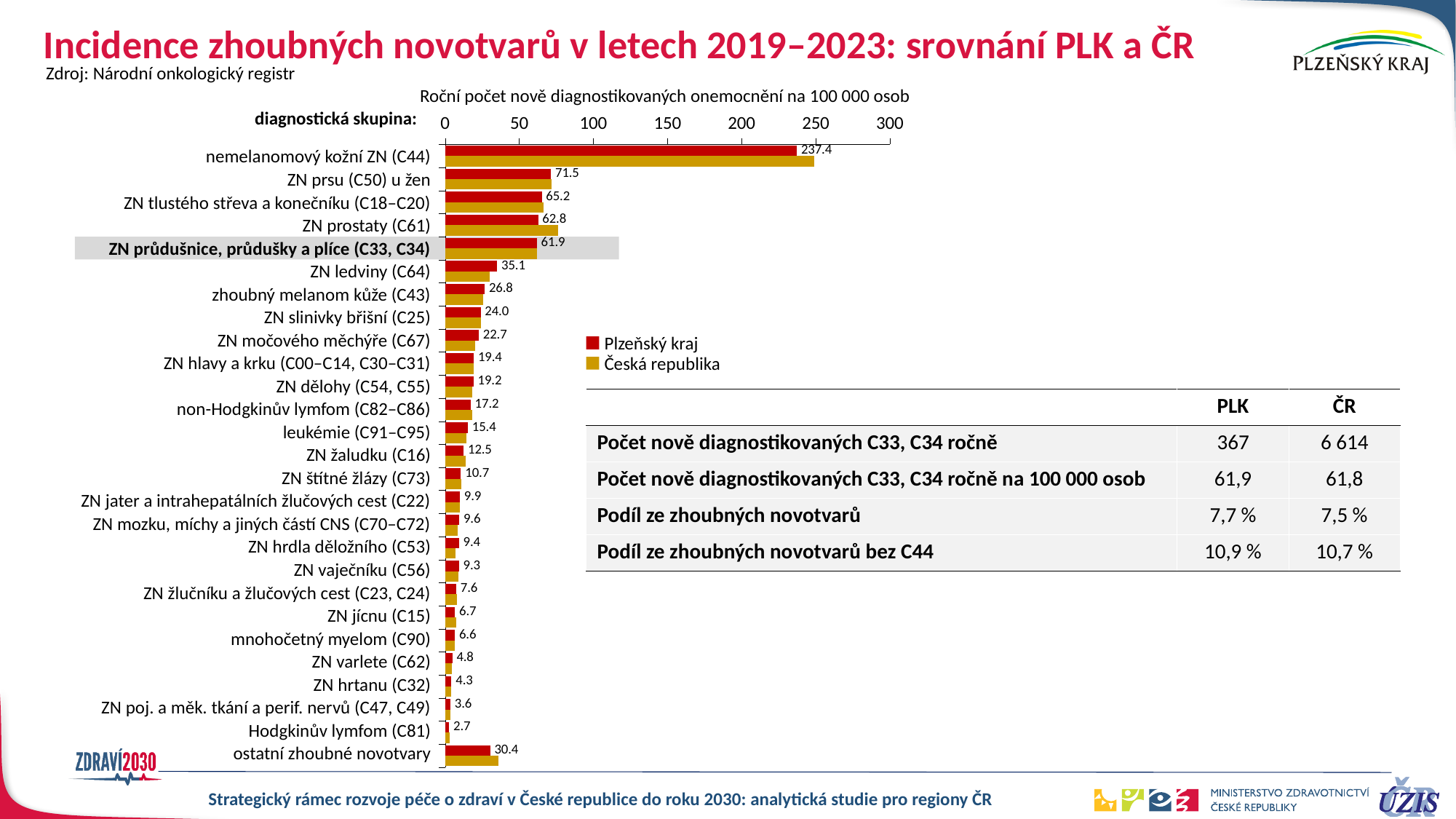
Which diagnostic group has the lowest Plzeňský kraj value? Hodgkinův lymfom (C81) What is the Plzeňský kraj value for ostatní zhoubné novotvary? 30.4 What is the Plzeňský kraj value for ZN prsu (C50) u žen? 71.5 Which has the larger Plzeňský kraj value: ZN ledviny (C64) or zhoubný melanom kůže (C43)? ZN ledviny (C64) How many diagnostic groups are shown in the chart? 27 What is the difference between the Plzeňský kraj values for ZN prsu (C50) u žen and ZN tlustého střeva a konečníku (C18–C20)? 6.3 What kind of chart is shown on the slide? bar chart What is the Plzeňský kraj value for ZN ledviny (C64)? 35.1 How many series does the legend list? 2 Is the Česká republika value for nemelanomový kožní ZN (C44) greater or less than 200? greater Which diagnostic group has the highest Plzeňský kraj value? nemelanomový kožní ZN (C44) Is the Česká republika value for ZN prsu (C50) u žen greater or less than 50? greater